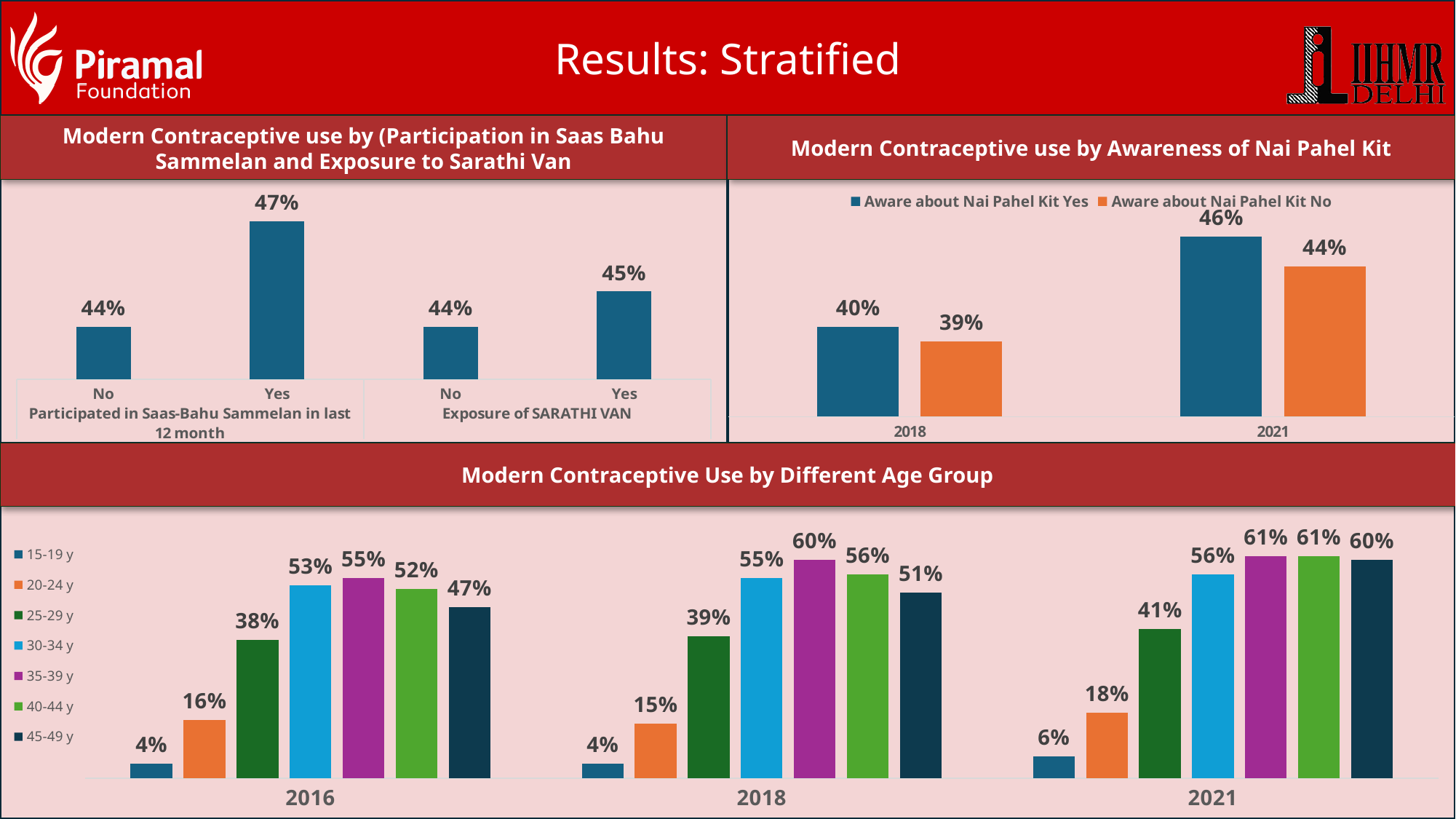
In the 'Modern Contraceptive Use by Different Age Group' chart, what is the difference between the 45-49 y values in 2021 and 2016? 13% In the 'Modern Contraceptive use by Awareness of Nai Pahel Kit' chart, what is the value for 'Aware about Nai Pahel Kit No' in 2018? 39% In the 'Modern Contraceptive use by Awareness of Nai Pahel Kit' chart, does the value for 'Aware about Nai Pahel Kit Yes' rise or fall from 2018 to 2021? rise In the 'Modern Contraceptive use by (Participation in Saas Bahu Sammelan and Exposure to Sarathi Van' chart, what is the difference between Yes and No for exposure of SARATHI VAN? 1% What kind of chart is 'Modern Contraceptive Use by Different Age Group'? bar chart How many series does the legend list in the 'Modern Contraceptive use by Awareness of Nai Pahel Kit' chart? 2 In the 'Modern Contraceptive use by (Participation in Saas Bahu Sammelan and Exposure to Sarathi Van' chart, what is the value for 'No' exposure of SARATHI VAN? 44% In the 'Modern Contraceptive Use by Different Age Group' chart, which age group has the lowest value in 2021? 15-19 y How many series does the legend list in the 'Modern Contraceptive Use by Different Age Group' chart? 7 In the 'Modern Contraceptive use by (Participation in Saas Bahu Sammelan and Exposure to Sarathi Van' chart, what is the value for those who participated in Saas-Bahu Sammelan in the last 12 months (Yes)? 47% In the 'Modern Contraceptive use by Awareness of Nai Pahel Kit' chart, what is the value for 'Aware about Nai Pahel Kit Yes' in 2021? 46% In the 'Modern Contraceptive Use by Different Age Group' chart, what is the value for the 35-39 y group in 2018? 60%